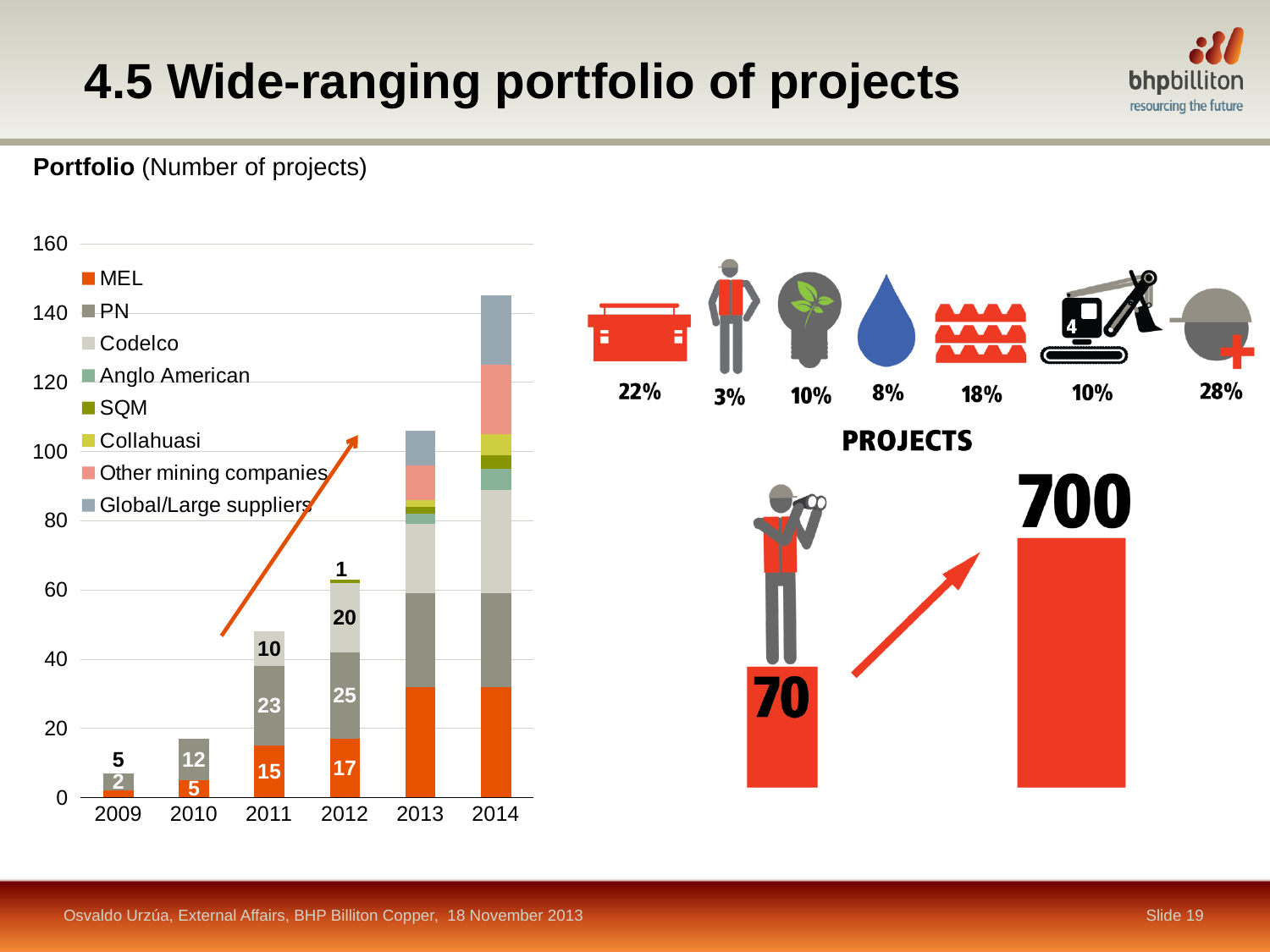
What is the value for MEL in 2009? 2 Which year has the lowest total number of projects? 2009 What is the difference between the PN value in 2012 and the PN value in 2011? 2 What is the value for PN in 2012? 25 What is the value for Codelco in 2011? 10 In 2012, which is larger: the MEL value or the Codelco value? Codelco How many series does the legend list? 8 Which year has the highest total number of projects? 2014 What is the value for MEL in 2011? 15 Do the total values rise or fall from 2009 to 2014? rise Is the total for 2014 greater or less than 140? greater What is the total number of projects in the 2010 bar? 17